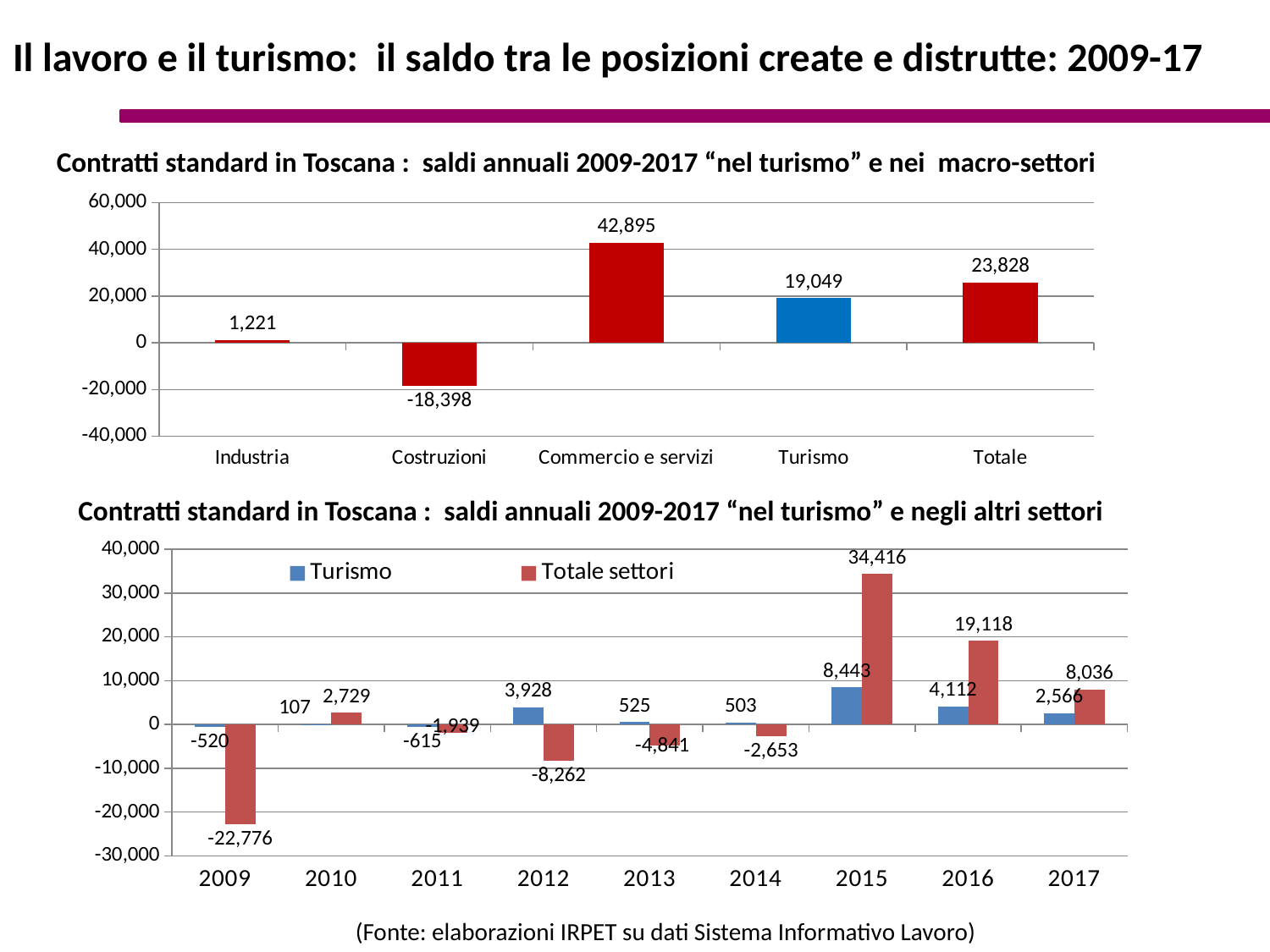
In the top chart (macro-settori), what is the value for Commercio e servizi? 42,895 What type of chart is the bottom chart (altri settori)? Bar chart In the top chart (macro-settori), what is the difference between the values for Totale and Turismo? 4,779 In the top chart (macro-settori), what is the value for Costruzioni? -18,398 In the top chart (macro-settori), which category has the lowest value? Costruzioni In the top chart (macro-settori), which category has the highest value? Commercio e servizi In the bottom chart (altri settori), how many series does the legend list? 2 In the bottom chart (altri settori), in which year is the Totale settori value lowest? 2009 In the bottom chart (altri settori), what is the value for Turismo in 2012? 3,928 In the bottom chart (altri settori), what is the value for Totale settori in 2015? 34,416 In the bottom chart (altri settori), which is larger in 2012: Turismo or Totale settori? Turismo In the top chart (macro-settori), how many categories are shown on the x axis? 5